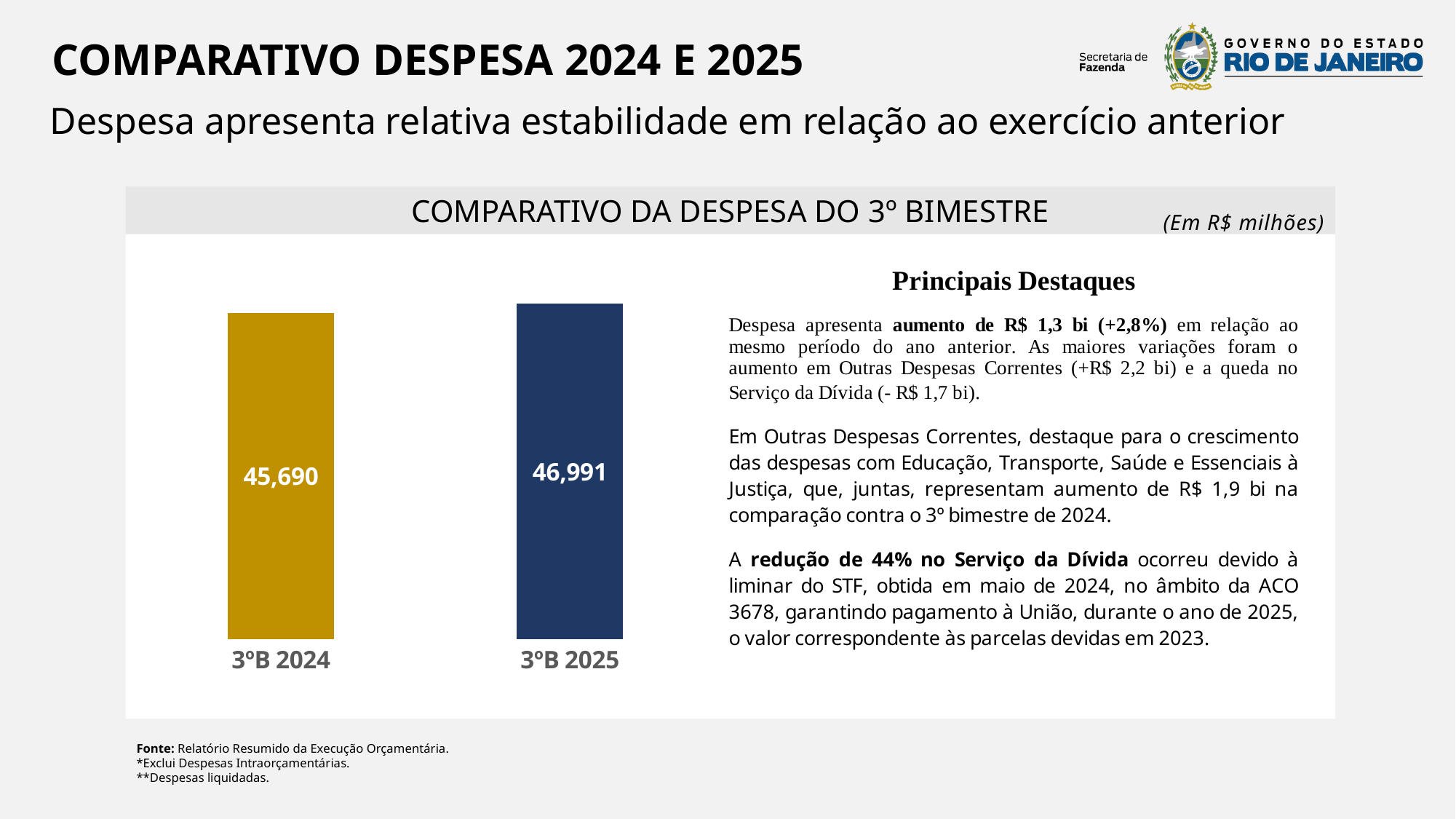
What is the difference between the values for 3ºB 2025 and 3ºB 2024? 1,301 What is the title of the chart? COMPARATIVO DA DESPESA DO 3º BIMESTRE Which is larger, the value for 3ºB 2024 or 3ºB 2025? 3ºB 2025 What kind of chart is shown on the slide? Bar chart Which category has the lowest value? 3ºB 2024 Do the values rise or fall from 3ºB 2024 to 3ºB 2025? Rise In what unit are the chart values expressed? R$ milhões What is the value for 3ºB 2025? 46,991 How many bars are shown in the chart? 2 What is the value for 3ºB 2024? 45,690 Which category has the highest value? 3ºB 2025